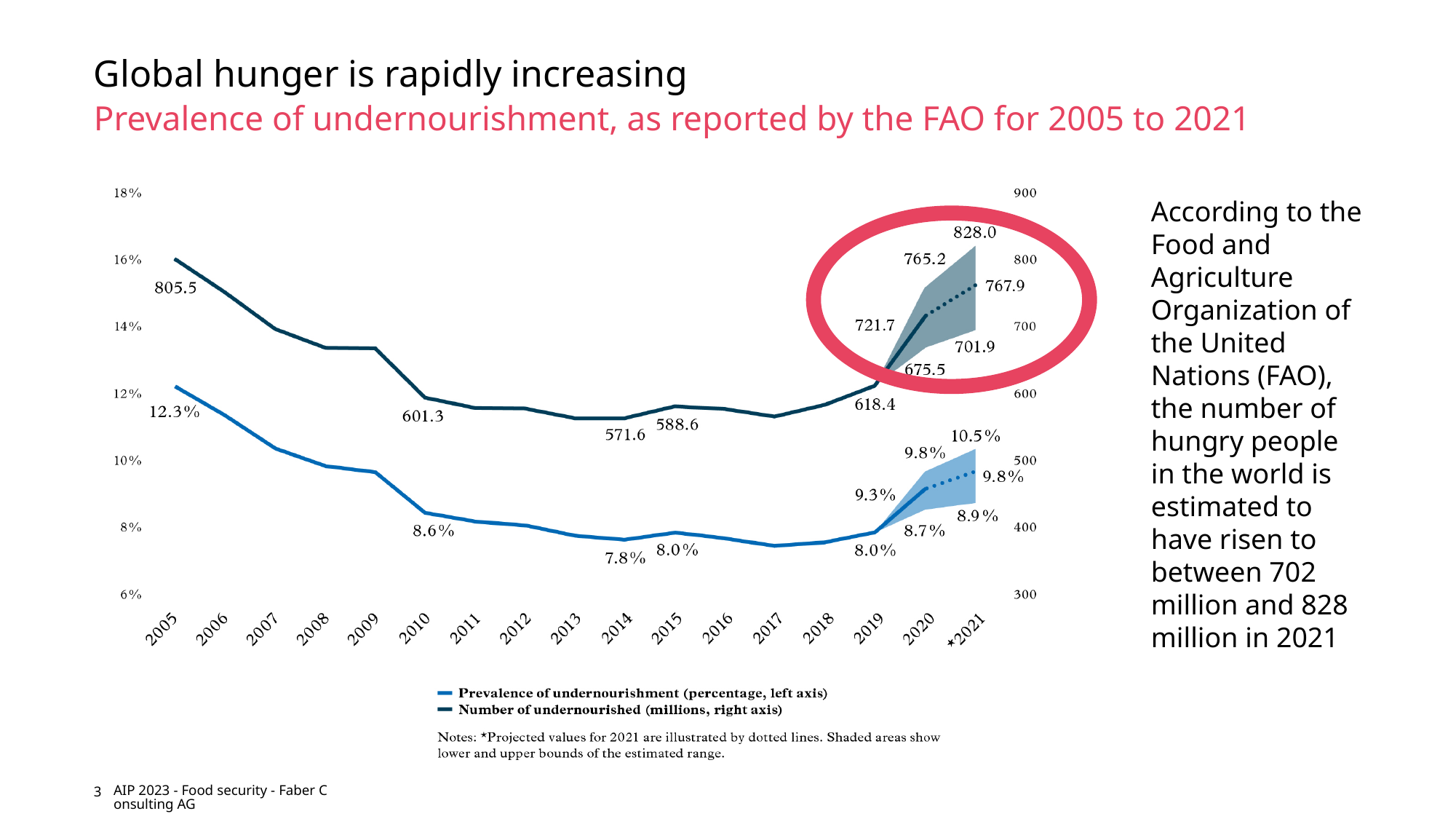
Did the number of undernourished rise or fall between 2005 and 2010? fall What was the number of undernourished (millions) in 2005? 805.5 What was the number of undernourished (millions) in 2019? 618.4 What was the prevalence of undernourishment in 2005? 12.3% What type of chart is shown on the slide? line chart In which labelled year was the number of undernourished (millions) lowest? 2014 What is the difference between the number of undernourished in 2005 and in 2010 (millions)? 204.2 What is the upper bound of the estimated number of undernourished (millions) for 2021? 828.0 How many series does the legend list? 2 What is the projected prevalence of undernourishment for 2021? 9.8% Which is larger, the prevalence of undernourishment in 2010 or in 2014? 2010 How many years are shown on the x axis? 17